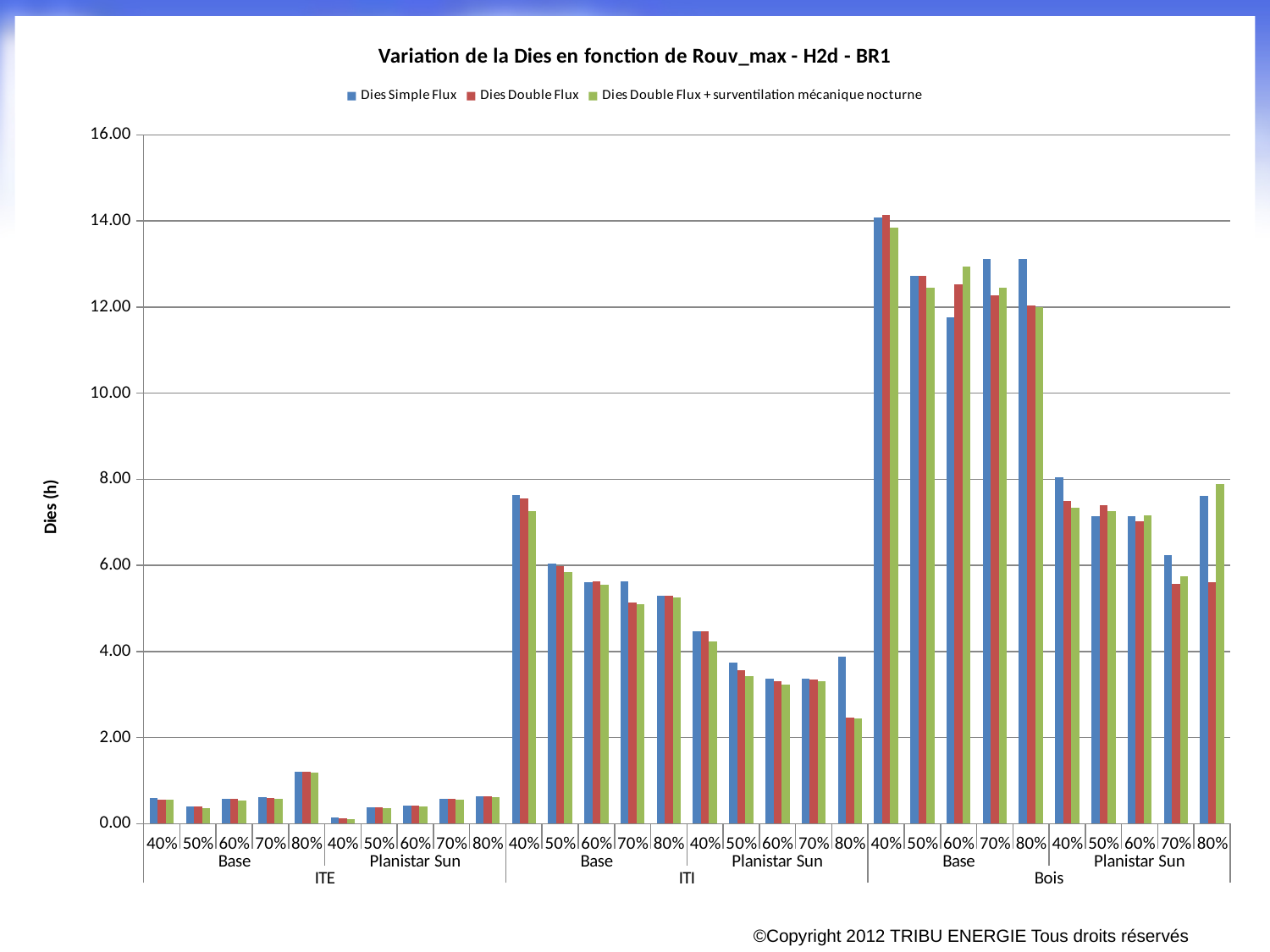
How many series does the legend list? 3 For Bois Planistar Sun 80%, which is larger: Dies Double Flux or Dies Double Flux + surventilation mécanique nocturne? Dies Double Flux + surventilation mécanique nocturne What is the title of the chart? Variation de la Dies en fonction de Rouv_max - H2d - BR1 How many Rouv_max percentage categories are shown within each Base or Planistar Sun group? 5 What kind of chart is shown on the slide? bar chart For ITI Planistar Sun 80%, which is larger: Dies Simple Flux or Dies Double Flux? Dies Simple Flux What is the label of the vertical axis? Dies (h) Is the Dies Simple Flux value for Bois Base 40% greater or less than 12.00? greater How many main wall-type groups (ITE, ITI, Bois) are shown along the x axis? 3 Which category has the highest Dies Simple Flux value? Bois Base 40% Which category has the lowest Dies Simple Flux value? ITE Planistar Sun 40% Is the Dies Double Flux value for Bois Planistar Sun 80% greater or less than 6.00? less